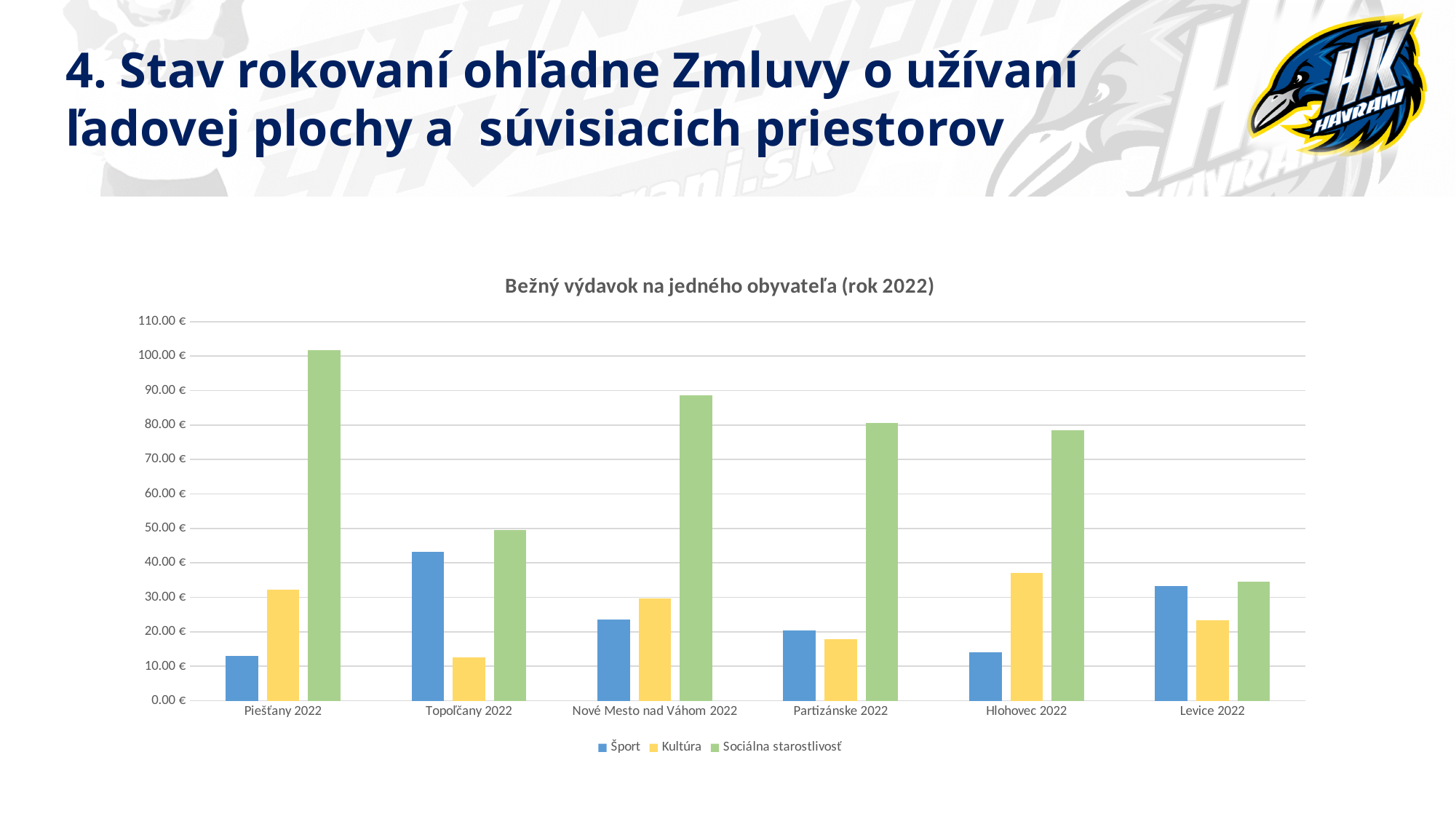
Is the value for Kultúra in Topoľčany 2022 greater or less than 20.00 €? less Which category has the highest value for Šport? Topoľčany 2022 How many categories (towns) are shown on the x axis? 6 How many series does the legend list? 3 Is the value for Šport in Topoľčany 2022 greater or less than 40.00 €? greater In Hlohovec 2022, which is larger: Šport or Kultúra? Kultúra What kind of chart is shown on the slide? bar chart Which category has the lowest value for Kultúra? Topoľčany 2022 Is the value for Sociálna starostlivosť in Piešťany 2022 greater or less than 90.00 €? greater Which category has the highest value for Sociálna starostlivosť? Piešťany 2022 What is the title of the chart? Bežný výdavok na jedného obyvateľa (rok 2022) In Levice 2022, which is larger: Šport or Kultúra? Šport